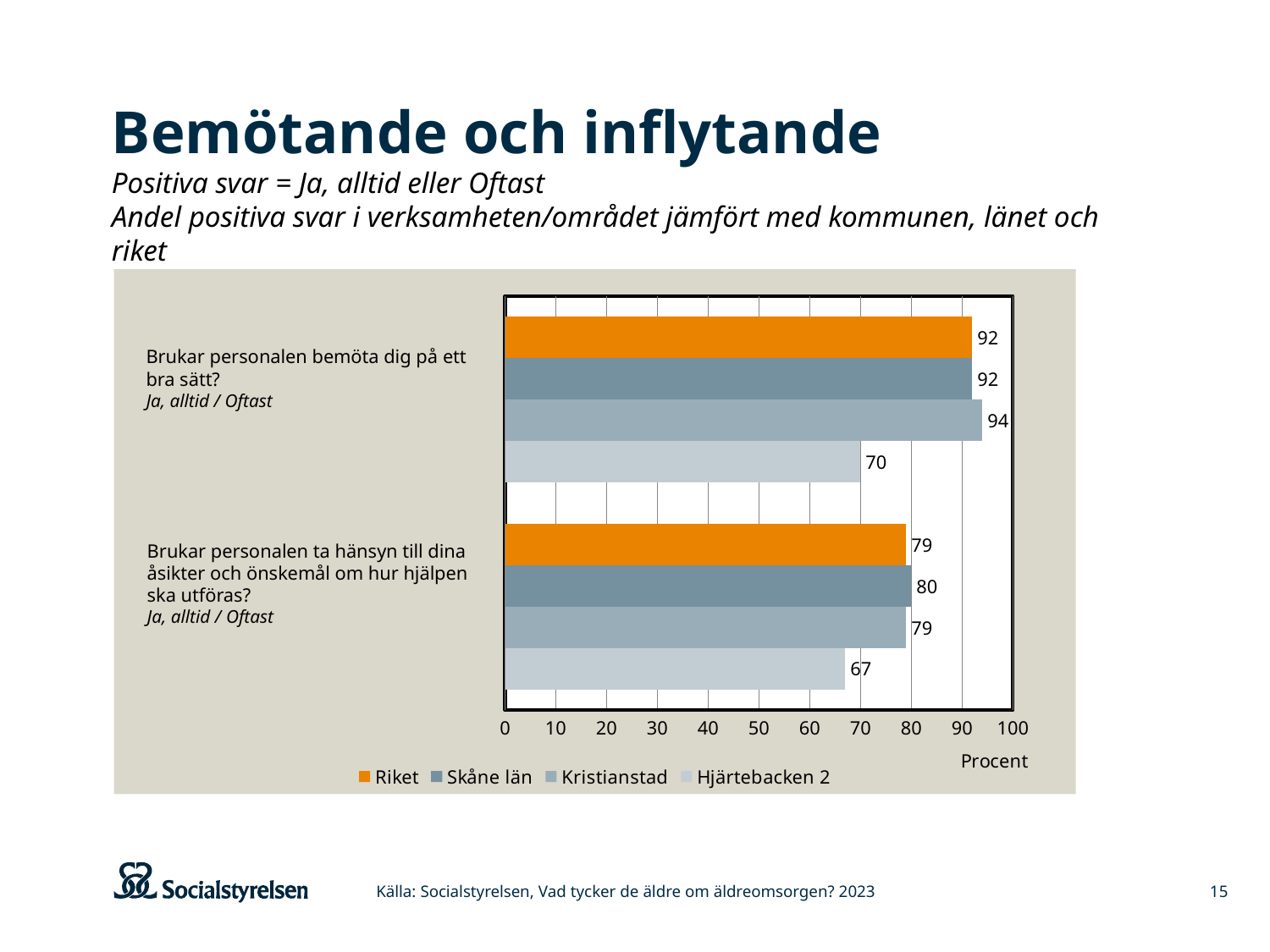
What is the label on the horizontal axis of the chart? Procent What is the value for Kristianstad for the question "Brukar personalen bemöta dig på ett bra sätt?"? 94 How many series does the legend list? 4 What is the difference between the Kristianstad value and the Hjärtebacken 2 value for the question "Brukar personalen bemöta dig på ett bra sätt?"? 24 What is the value for Hjärtebacken 2 for the question "Brukar personalen bemöta dig på ett bra sätt?"? 70 Which series has the lowest value for the question "Brukar personalen ta hänsyn till dina åsikter och önskemål om hur hjälpen ska utföras?"? Hjärtebacken 2 Which series has the highest value for the question "Brukar personalen bemöta dig på ett bra sätt?"? Kristianstad Which is larger for Hjärtebacken 2: the value for "Brukar personalen bemöta dig på ett bra sätt?" or the value for "Brukar personalen ta hänsyn till dina åsikter och önskemål om hur hjälpen ska utföras?"? Brukar personalen bemöta dig på ett bra sätt? What is the difference between the Skåne län value and the Hjärtebacken 2 value for the question "Brukar personalen ta hänsyn till dina åsikter och önskemål om hur hjälpen ska utföras?"? 13 What is the value for Skåne län for the question "Brukar personalen ta hänsyn till dina åsikter och önskemål om hur hjälpen ska utföras?"? 80 What is the value for Riket for the question "Brukar personalen ta hänsyn till dina åsikter och önskemål om hur hjälpen ska utföras?"? 79 What kind of chart is shown on the slide? Bar chart